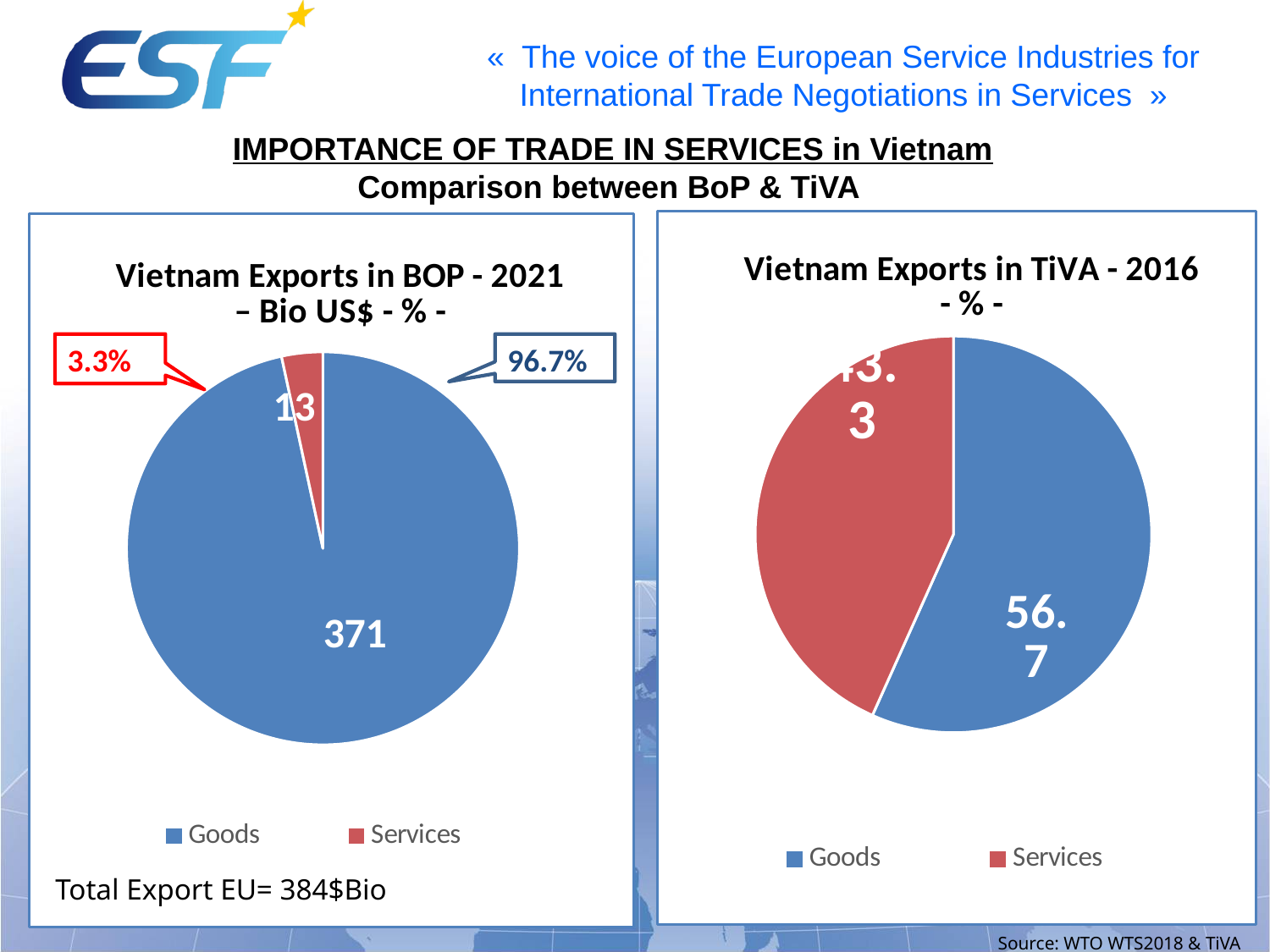
In the 'Vietnam Exports in BOP - 2021' chart on the left, what share of the pie does Goods represent? 96.7% In the 'Vietnam Exports in BOP - 2021' chart on the left, which category has the largest slice? Goods How many categories does the legend of the 'Vietnam Exports in TiVA - 2016' chart on the right list? 2 What kind of chart is the 'Vietnam Exports in BOP - 2021' chart on the left? Pie chart In the 'Vietnam Exports in BOP - 2021' chart on the left, what share of the pie does Services represent? 3.3% In the 'Vietnam Exports in TiVA - 2016' chart on the right, which category has the larger slice? Goods In the 'Vietnam Exports in BOP - 2021' chart on the left, what is the value for Goods? 371 In the 'Vietnam Exports in TiVA - 2016' chart on the right, which colour represents Services? Red In the 'Vietnam Exports in BOP - 2021' chart on the left, what is the total of the Goods and Services values? 384 In the 'Vietnam Exports in BOP - 2021' chart on the left, what is the value for Services? 13 In the 'Vietnam Exports in BOP - 2021' chart on the left, what is the difference between the Goods value and the Services value? 358 In the 'Vietnam Exports in TiVA - 2016' chart on the right, what is the value for Goods? 56.7